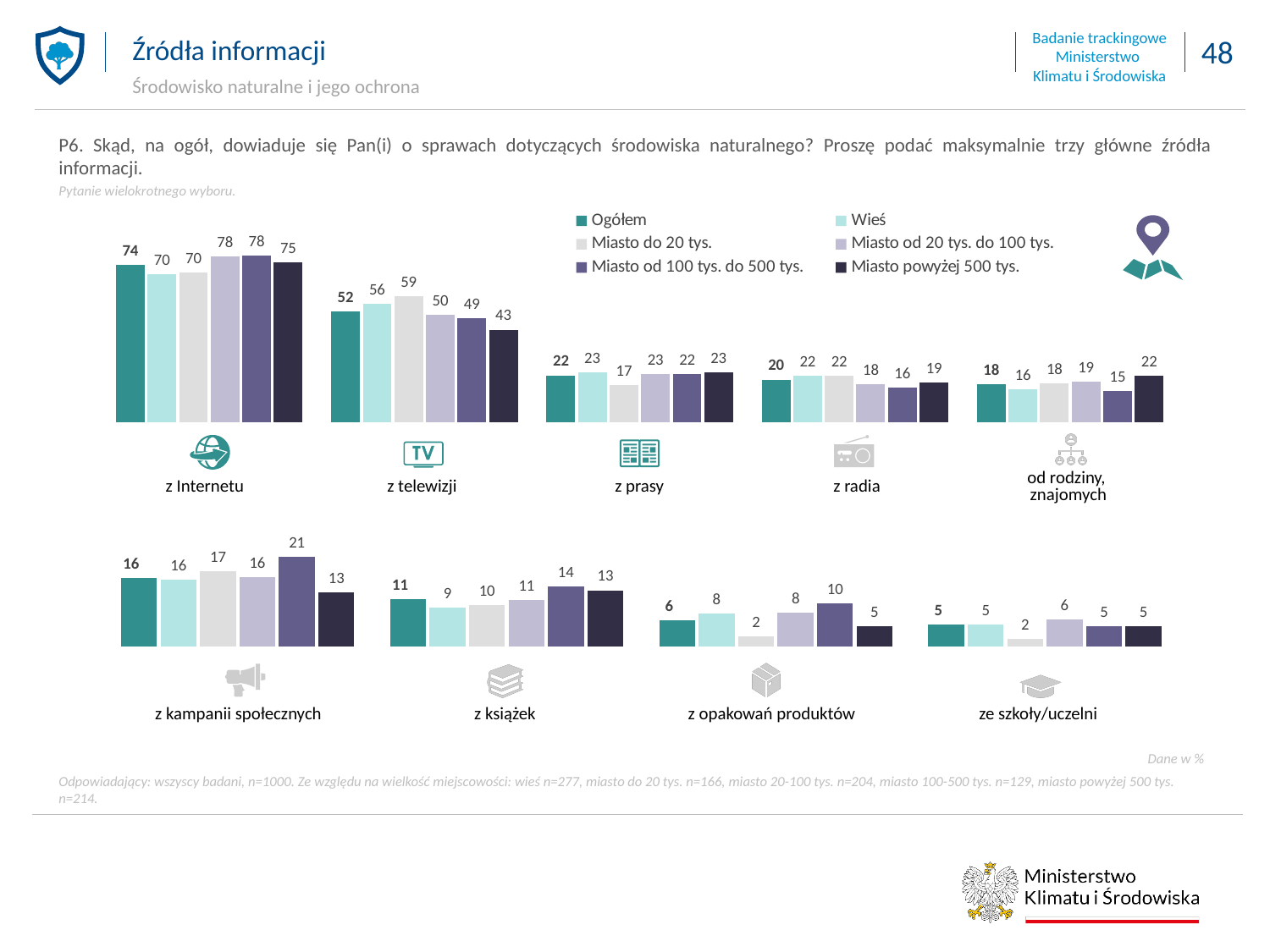
What is the Wieś value for z opakowań produktów? 8 Which information source has the lowest Ogółem value? ze szkoły/uczelni How many information sources (categories) are shown in the chart? 9 Which information source has the highest Ogółem value? z Internetu What is the Miasto do 20 tys. value for ze szkoły/uczelni? 2 How many series does the legend list? 6 What kind of chart is shown on the slide? bar chart What is the Ogółem value for z Internetu? 74 What is the difference between the Wieś and Miasto do 20 tys. values for z prasy? 6 What is the difference between the Ogółem values for z Internetu and z telewizji? 22 For z kampanii społecznych, which is larger: the value for Miasto od 100 tys. do 500 tys. or the value for Miasto powyżej 500 tys.? Miasto od 100 tys. do 500 tys. What is the value for Miasto powyżej 500 tys. for z telewizji? 43